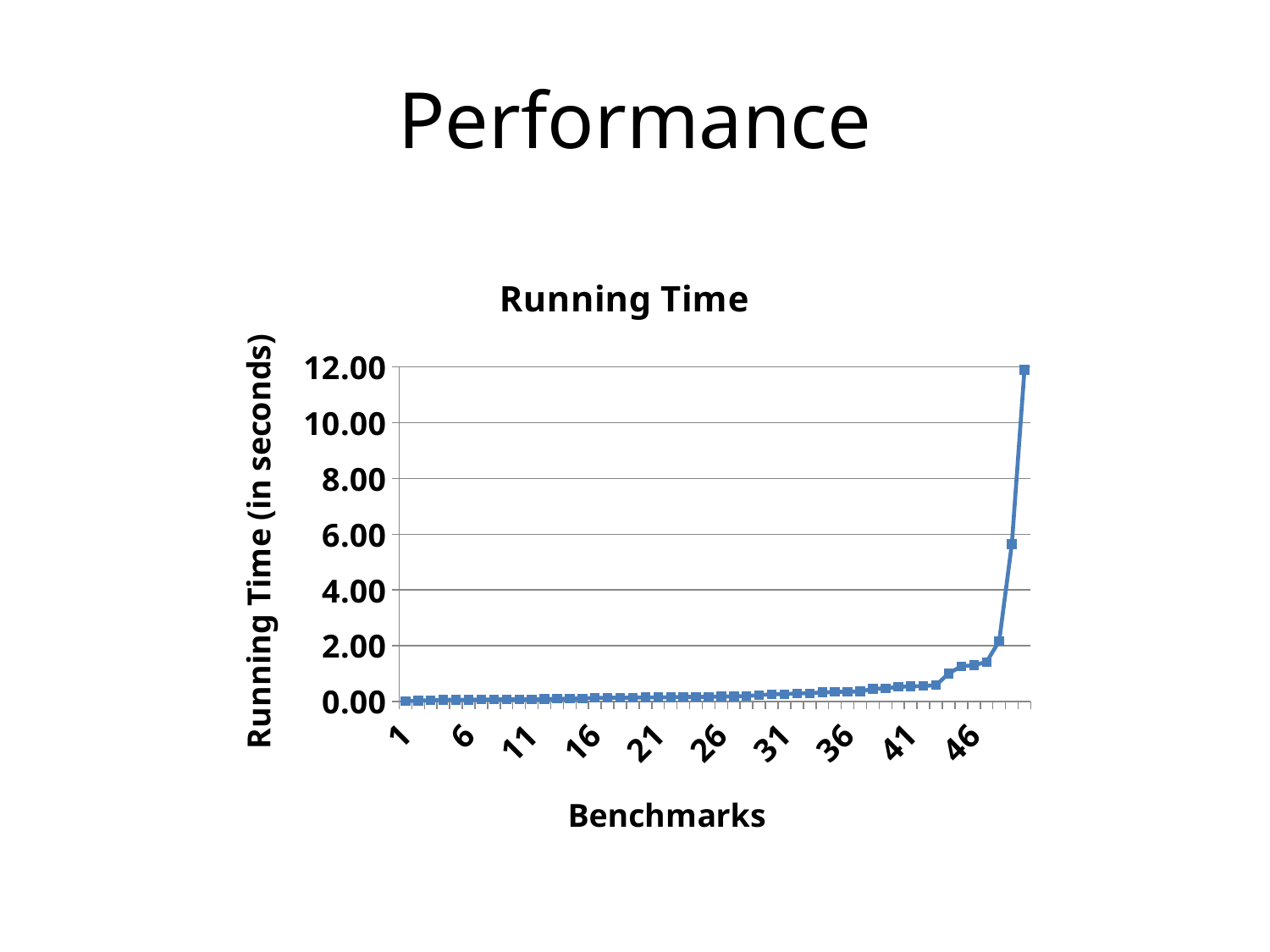
Is the running time for benchmark 26 greater or less than 2.00? less Which has the larger running time, benchmark 6 or the rightmost benchmark? the rightmost benchmark What kind of chart is shown on the slide? line chart Is the running time for the second-to-last benchmark greater or less than 8.00? less What is the title of the chart? Running Time What is the label of the y axis? Running Time (in seconds) Is the running time for the rightmost benchmark greater or less than 10.00? greater Which benchmark has the highest running time, the leftmost or the rightmost? the rightmost Do the running time values rise or fall as you move from left to right along the x axis? rise